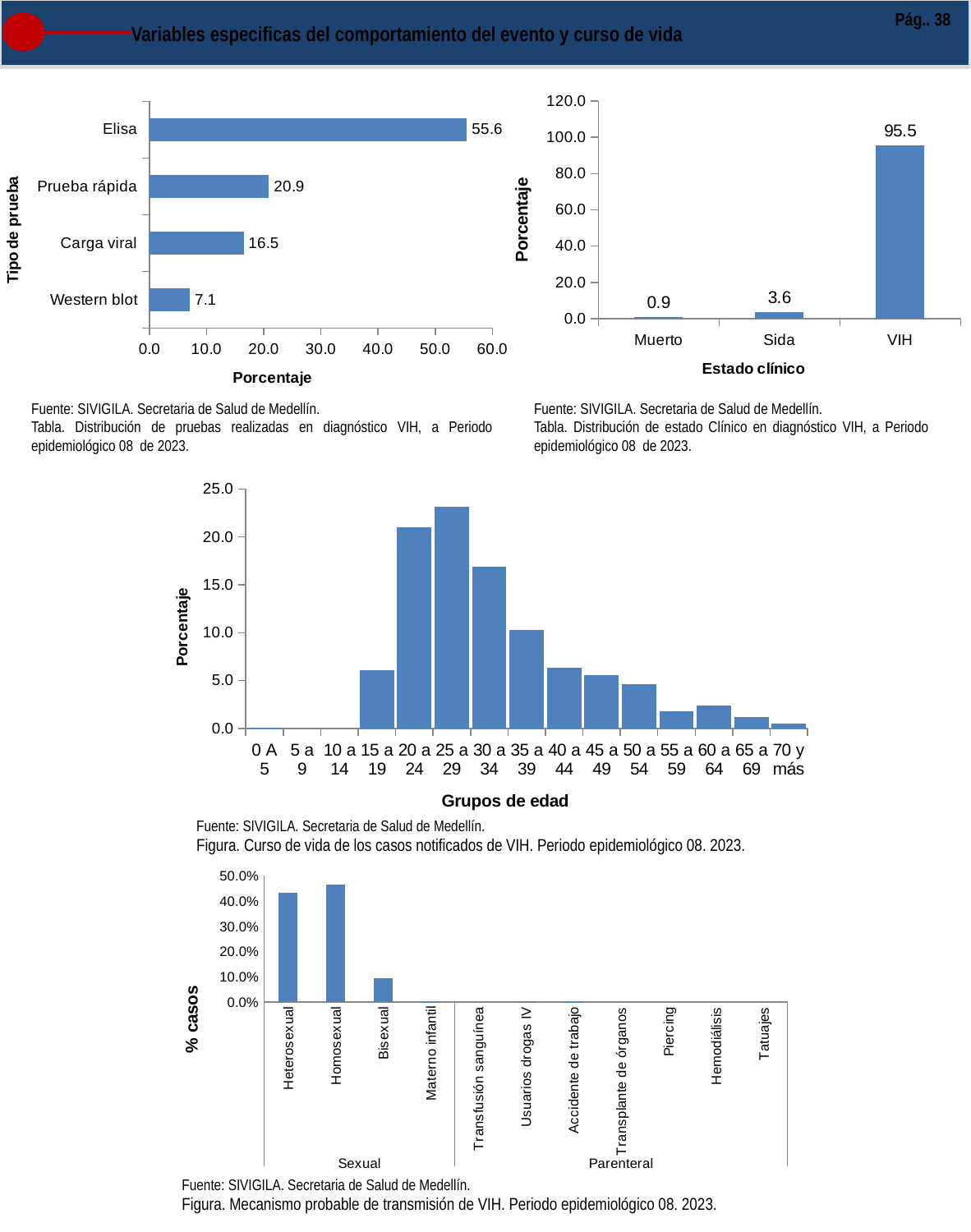
In the middle chart of age groups (Grupos de edad), is the value for 35 a 39 greater or less than 15.0? less In the top-left chart of test types (Tipo de prueba), how many test types are shown? 4 In the bottom chart of transmission mechanisms (% casos), is the value for Bisexual greater or less than 20.0%? less In the top-right chart of clinical status (Estado clínico), which category has the highest percentage? VIH In the bottom chart of transmission mechanisms (% casos), which of Heterosexual or Homosexual has the larger value? Homosexual In the top-left chart of test types (Tipo de prueba), what is the difference between Prueba rápida and Carga viral? 4.4 In the top-left chart of test types (Tipo de prueba), which test type has the lowest percentage? Western blot In the top-right chart of clinical status (Estado clínico), what is the value for Sida? 3.6 In the middle chart of age groups (Grupos de edad), which age group has the highest percentage? 25 a 29 In the top-left chart of test types (Tipo de prueba), what is the value for Elisa? 55.6 In the top-left chart of test types (Tipo de prueba), what is the value for Western blot? 7.1 In the top-right chart of clinical status (Estado clínico), what is the difference between VIH and Muerto? 94.6